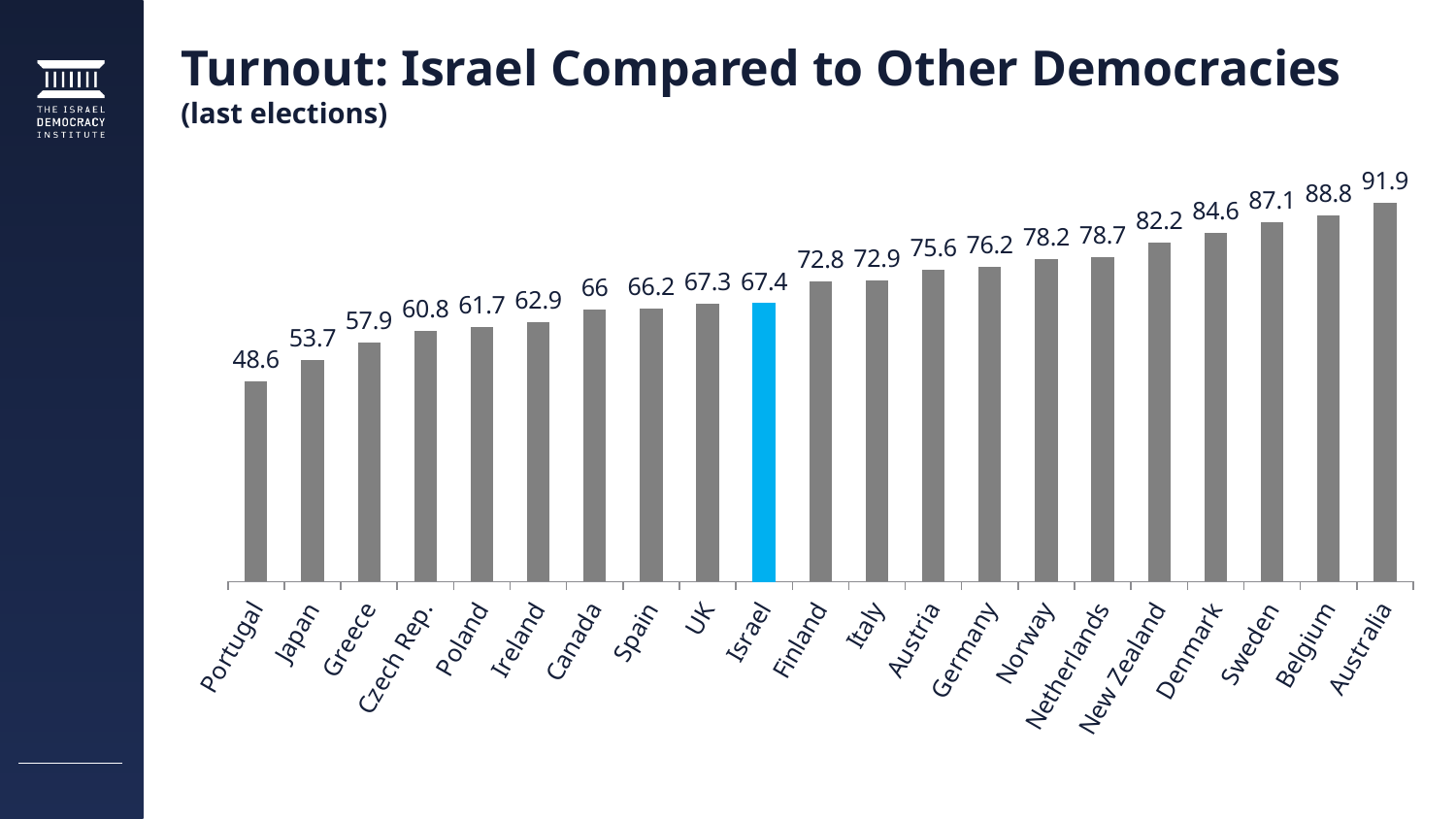
What kind of chart is shown on the slide? Bar chart What is the difference between the turnout for Germany and the turnout for Israel? 8.8 What is the turnout value shown for Germany? 76.2 Which has a higher turnout, Israel or Finland? Finland What is the turnout value shown for Israel? 67.4 Which country has the highest turnout on the chart? Australia What is the difference between the turnout for Australia and the turnout for Portugal? 43.3 What is the turnout value shown for Czech Rep.? 60.8 Which has a higher turnout, Japan or Ireland? Ireland Which country's bar is highlighted in a different colour (blue) from the others? Israel Which country has the lowest turnout on the chart? Portugal How many countries are shown on the chart? 21